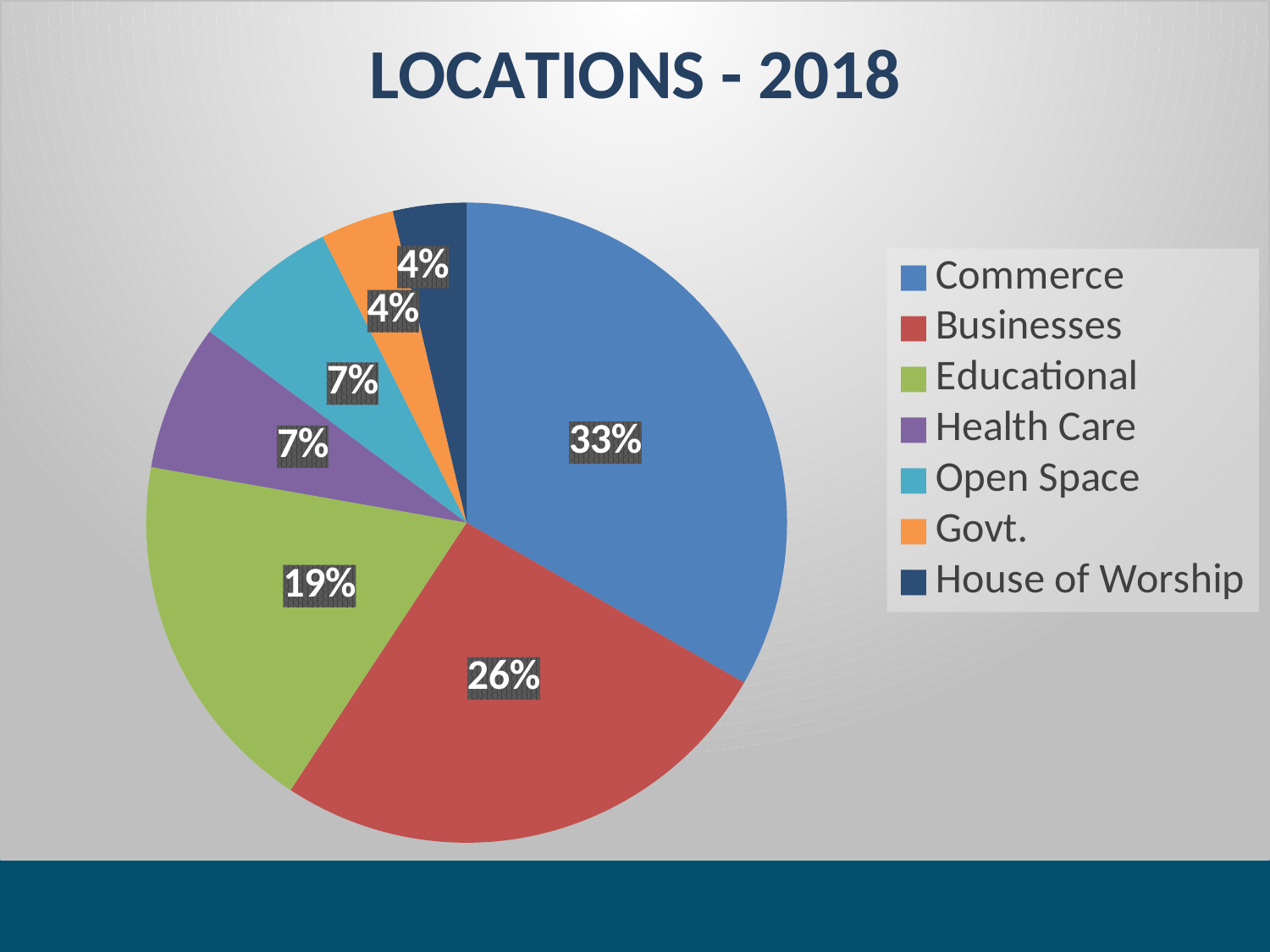
What is the difference in percentage points between Commerce and Businesses? 7 What is the difference in percentage points between Educational and Health Care? 12 What share of the pie does Govt. represent? 4% How many categories does the legend list? 7 Which category has the largest slice of the pie? Commerce Which is larger, the Businesses slice or the Educational slice? Businesses What kind of chart is shown on the slide? Pie chart Which is larger, the Open Space slice or the Govt. slice? Open Space What is the title of the chart? LOCATIONS - 2018 What share of the pie does Businesses represent? 26% What share of the pie does Educational represent? 19% What share of the pie does Commerce represent? 33%